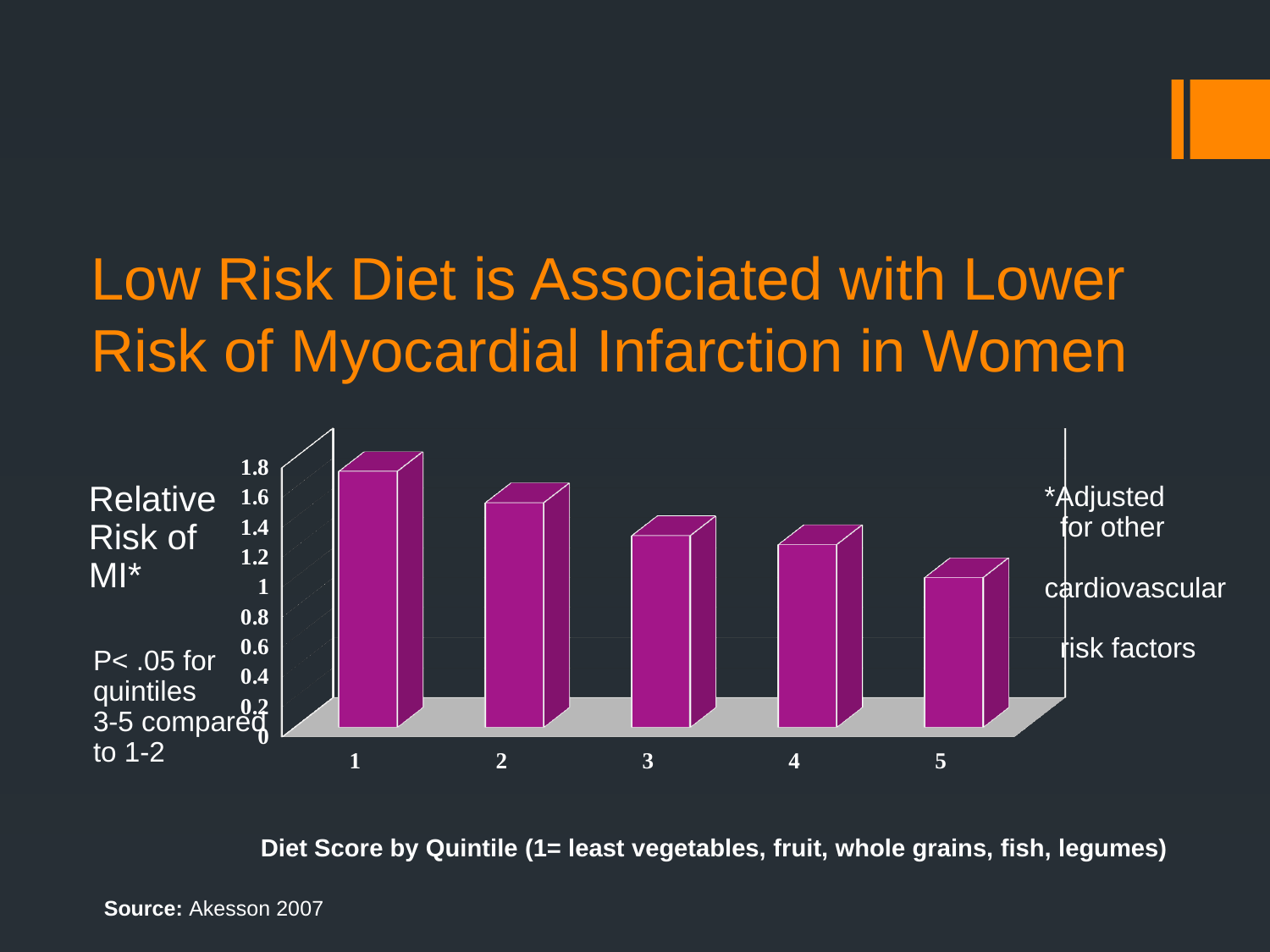
What kind of chart is shown on the slide? bar chart Which has a larger relative risk of MI, quintile 1 or quintile 5? quintile 1 Is the relative risk of MI for quintile 1 greater or less than 1.4? greater What is the label of the x axis of the chart? Diet Score by Quintile (1= least vegetables, fruit, whole grains, fish, legumes) What source is cited for the chart data? Akesson 2007 Which has a larger relative risk of MI, quintile 2 or quintile 4? quintile 2 Is the relative risk of MI for quintile 2 greater or less than 1? greater How many diet score quintiles are plotted on the chart? 5 Which quintile has the lowest relative risk of MI? 5 Which quintile has the highest relative risk of MI? 1 Is the relative risk of MI for quintile 5 greater or less than 1.4? less Do the relative risk values rise or fall as the diet score quintile increases from 1 to 5? fall